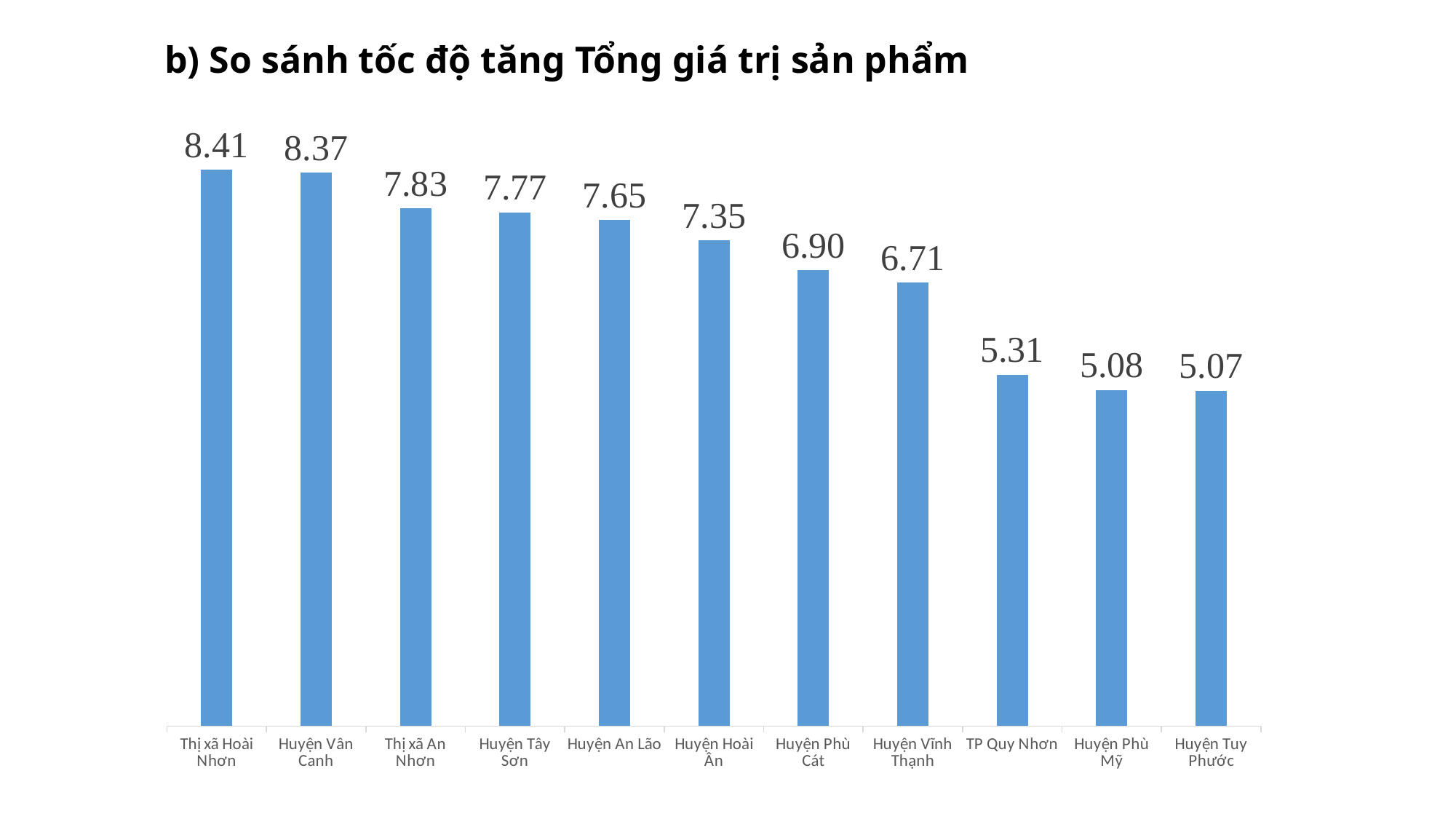
What is the value for TP Quy Nhơn? 5.31 What is the difference between the values for Thị xã An Nhơn and Huyện Phù Cát? 0.93 What is the difference between the values for Thị xã Hoài Nhơn and Huyện Tuy Phước? 3.34 What is the value for Thị xã Hoài Nhơn? 8.41 Do the values rise or fall from left to right along the x axis? Fall What is the value for Huyện Phù Cát? 6.90 What is the value for Huyện An Lão? 7.65 Which category has the highest value? Thị xã Hoài Nhơn How many categories are shown in the chart? 11 What kind of chart is shown on the slide? Bar chart Which is larger, the value for Huyện Hoài Ân or the value for Huyện Vĩnh Thạnh? Huyện Hoài Ân Which category has the lowest value? Huyện Tuy Phước